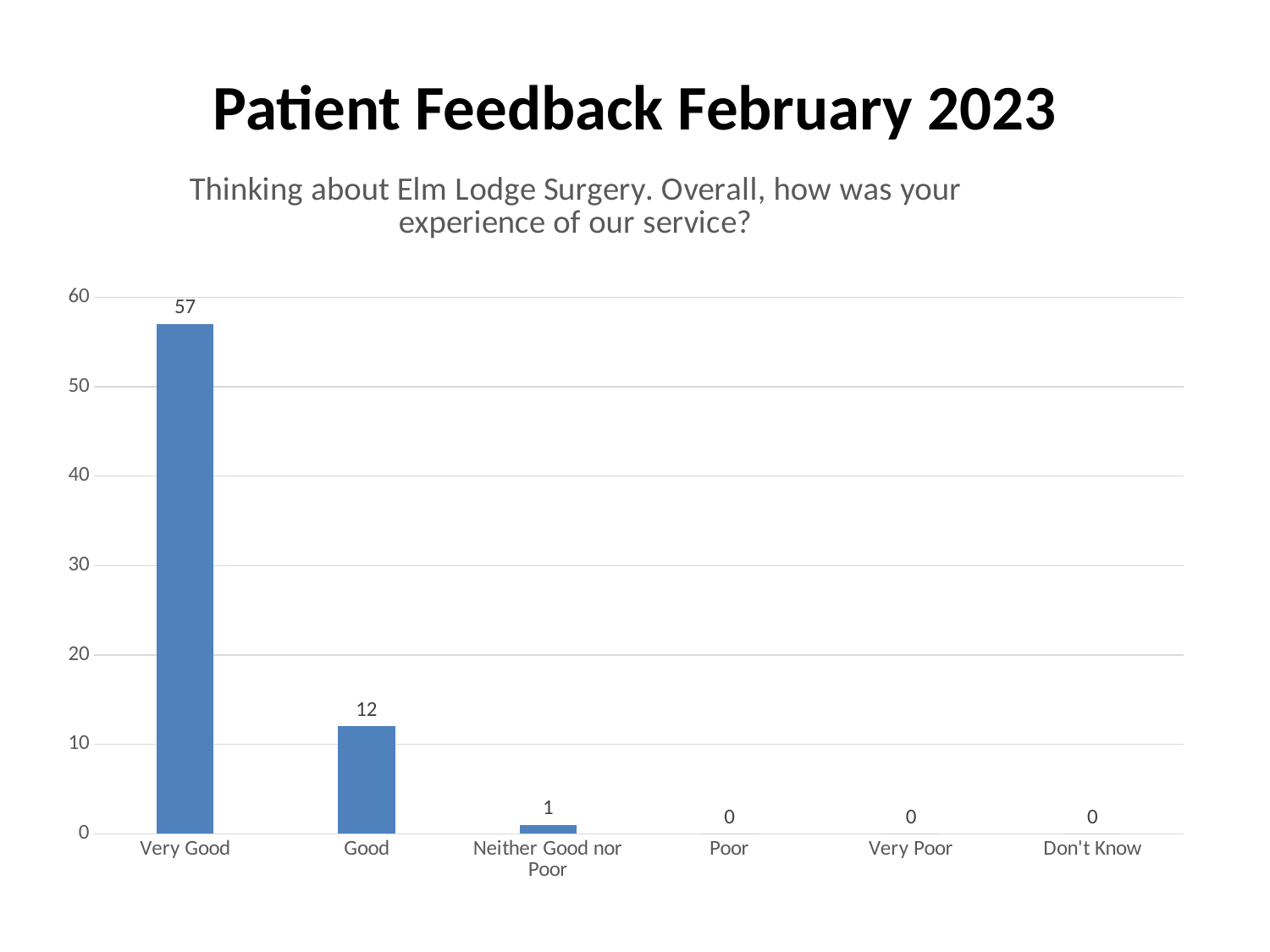
Which is larger, the value for Good or the value for Neither Good nor Poor? Good What is the value for Don't Know? 0 Is the value for Very Good greater or less than 50? greater Do the values rise or fall from Very Good to Neither Good nor Poor along the x axis? fall What is the value for Very Good? 57 What is the difference between the values for Very Good and Good? 45 How many categories are shown on the x axis? 6 What is the value for Good? 12 What is the value for Neither Good nor Poor? 1 Which category has the highest value? Very Good What kind of chart is shown on the slide? bar chart What is the title of the chart? Thinking about Elm Lodge Surgery. Overall, how was your experience of our service?